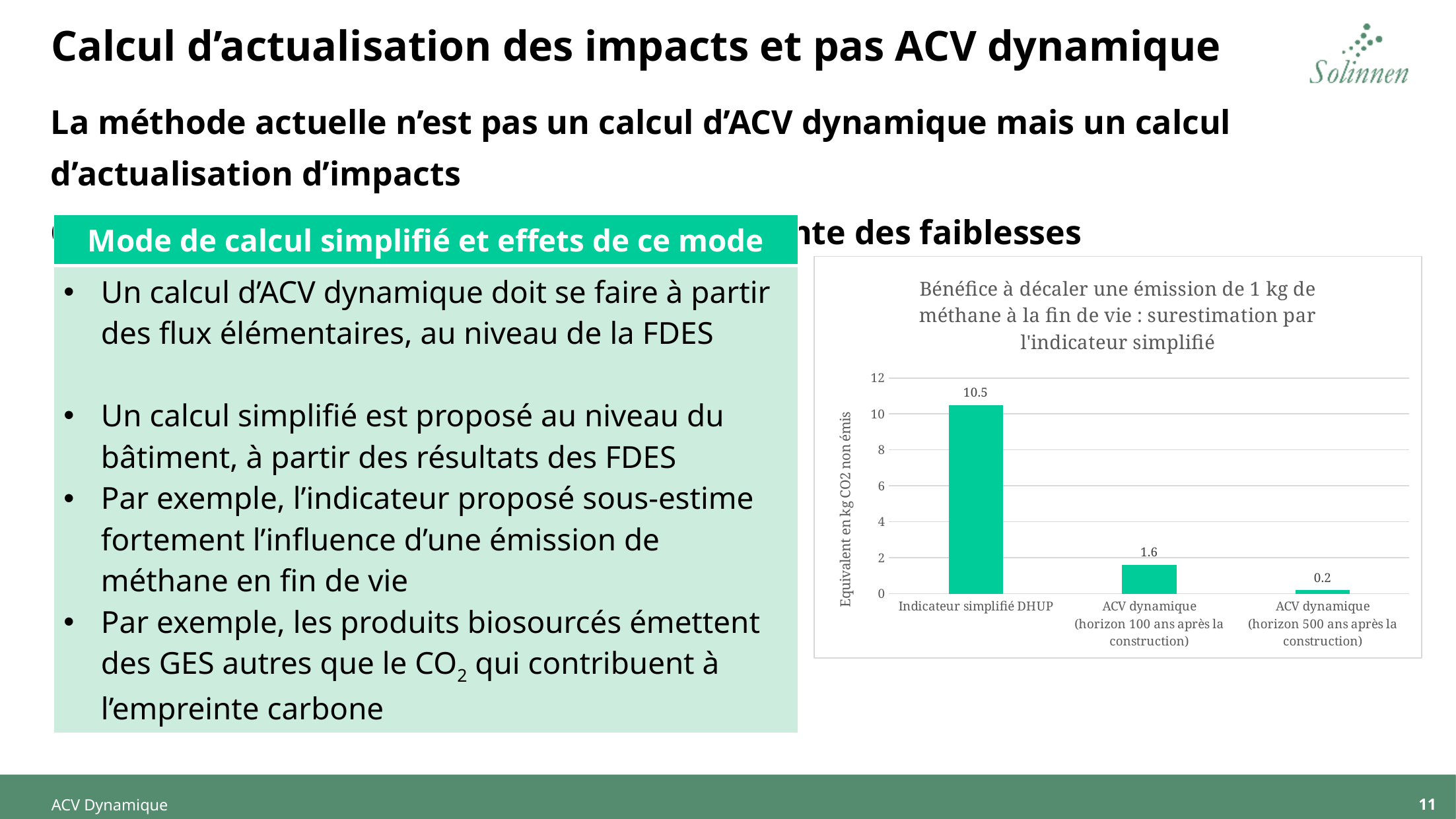
What is the value for 'ACV dynamique (horizon 500 ans après la construction)'? 0.2 Is the value for 'Indicateur simplifié DHUP' greater or less than 10? greater What is the label of the vertical axis of the chart? Equivalent en kg CO2 non émis What is the value for 'Indicateur simplifié DHUP'? 10.5 What is the difference between the value for 'ACV dynamique (horizon 100 ans après la construction)' and the value for 'ACV dynamique (horizon 500 ans après la construction)'? 1.4 Which category has the highest value? Indicateur simplifié DHUP Which category has the lowest value? ACV dynamique (horizon 500 ans après la construction) How many categories are shown in the chart? 3 What kind of chart is shown on the slide? bar chart What is the value for 'ACV dynamique (horizon 100 ans après la construction)'? 1.6 Which is larger: the value for 'ACV dynamique (horizon 100 ans après la construction)' or the value for 'ACV dynamique (horizon 500 ans après la construction)'? ACV dynamique (horizon 100 ans après la construction) What is the difference between the value for 'Indicateur simplifié DHUP' and the value for 'ACV dynamique (horizon 100 ans après la construction)'? 8.9